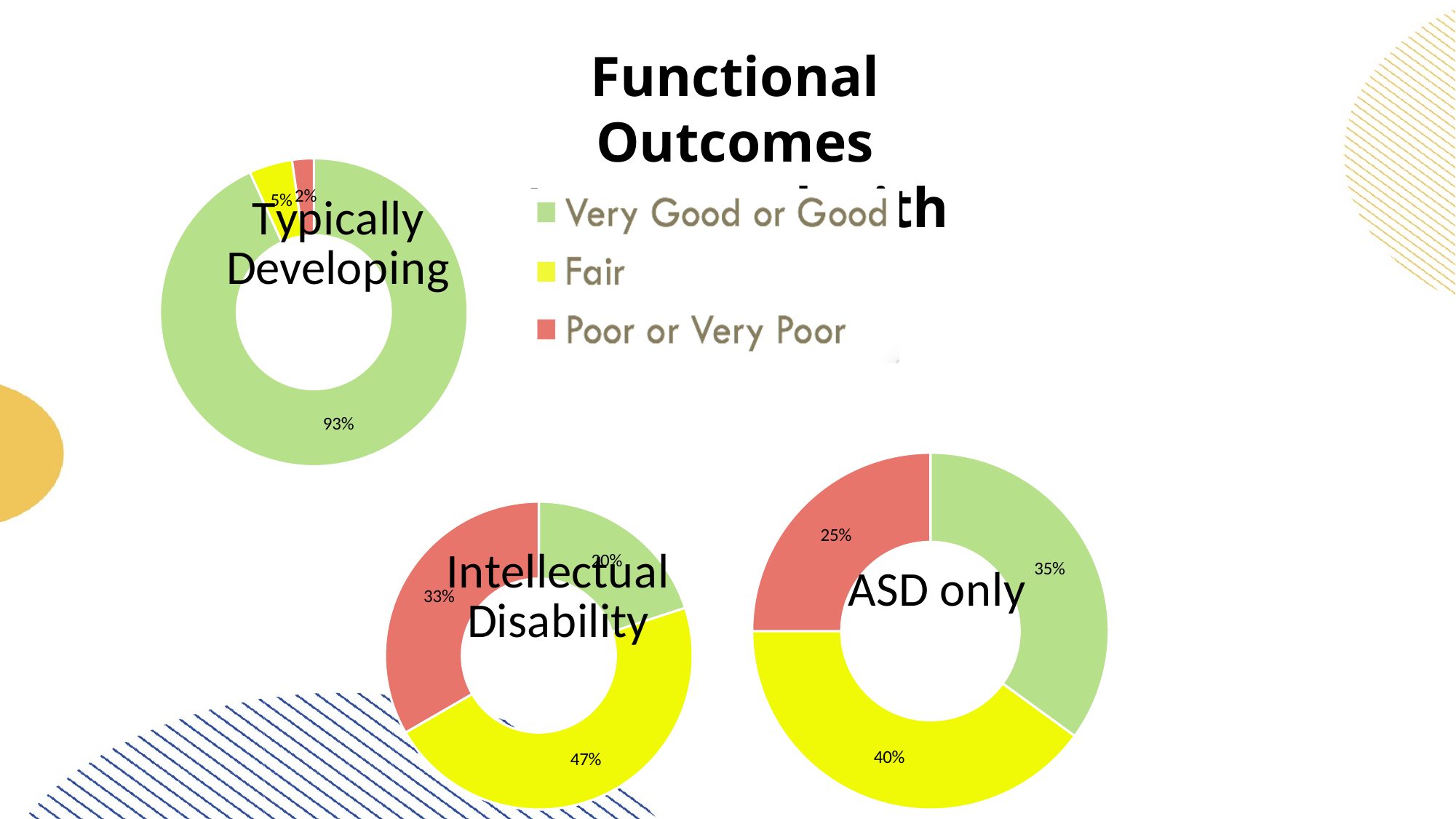
In the Typically Developing chart, what percentage is shown for Very Good or Good? 93% In the Intellectual Disability chart, what percentage is shown for Poor or Very Poor? 33% In the Intellectual Disability chart, what percentage is shown for Fair? 47% What is the difference between the Very Good or Good share in the Typically Developing chart and the Very Good or Good share in the ASD only chart? 58% In the ASD only chart, which category has the smallest share? Poor or Very Poor How many charts are shown on the slide? 3 Which is larger: the Poor or Very Poor share in the Intellectual Disability chart or the Poor or Very Poor share in the ASD only chart? Intellectual Disability In the Intellectual Disability chart, which category has the largest share? Fair In the ASD only chart, what percentage is shown for Fair? 40% In the Typically Developing chart, what percentage is shown for Fair? 5% What kind of chart is used for the Typically Developing data? Pie (donut) chart In the ASD only chart, what percentage is shown for Very Good or Good? 35%